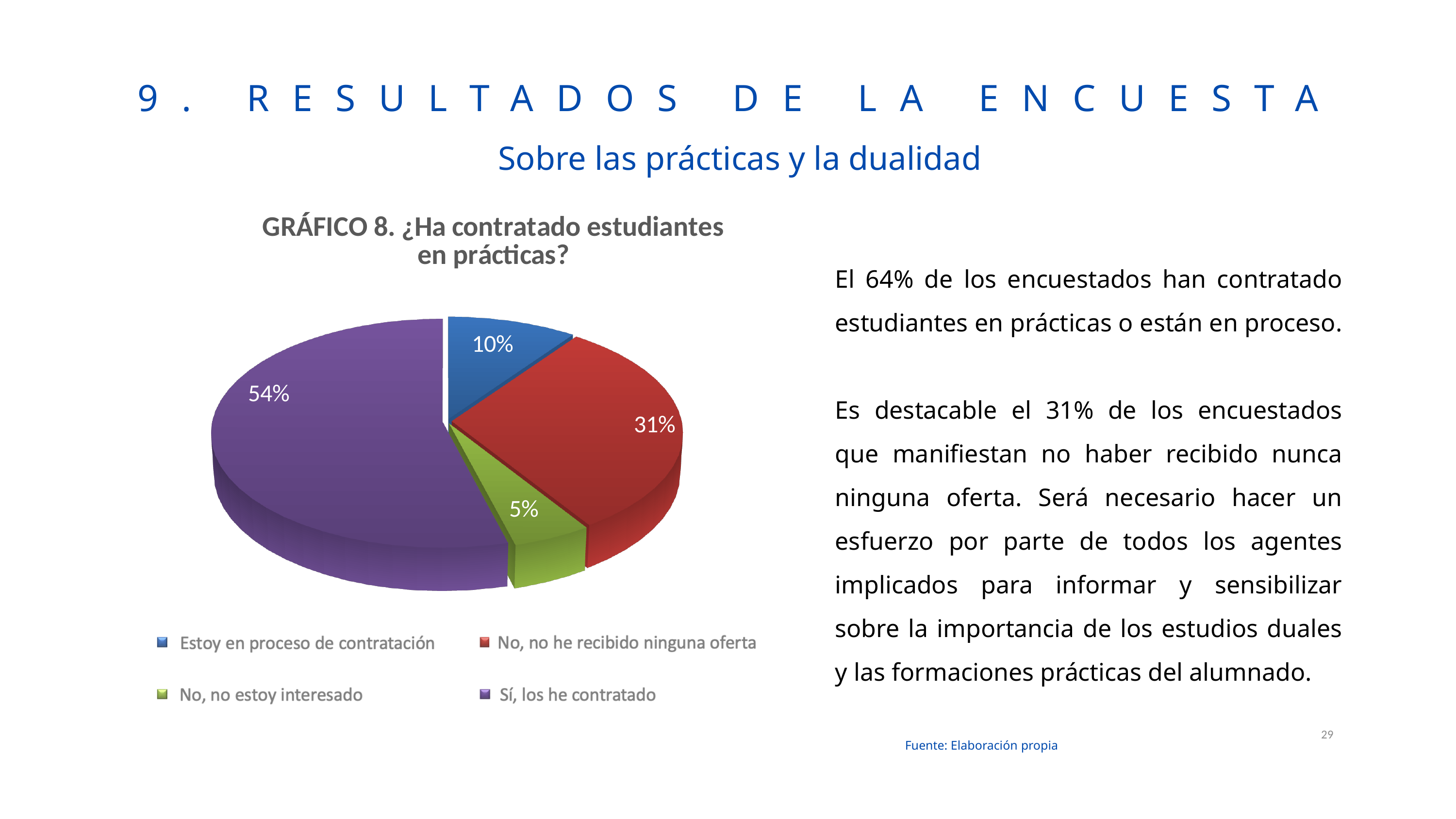
What is the value shown for "Estoy en proceso de contratación"? 10% Which is larger: the share for "Estoy en proceso de contratación" or for "No, no estoy interesado"? Estoy en proceso de contratación What share of the pie does "No, no he recibido ninguna oferta" represent? 31% What kind of chart is shown on the slide? Pie chart How many categories does the pie chart show? 4 What is the value shown for "No, no estoy interesado"? 5% Which category has the smallest slice of the pie? No, no estoy interesado What share of the pie does "Sí, los he contratado" represent? 54% What colour is the slice for "No, no he recibido ninguna oferta"? Red Which category has the largest slice of the pie? Sí, los he contratado What is the title of the chart? GRÁFICO 8. ¿Ha contratado estudiantes en prácticas? What is the difference between the shares for "Sí, los he contratado" and "No, no he recibido ninguna oferta"? 23%